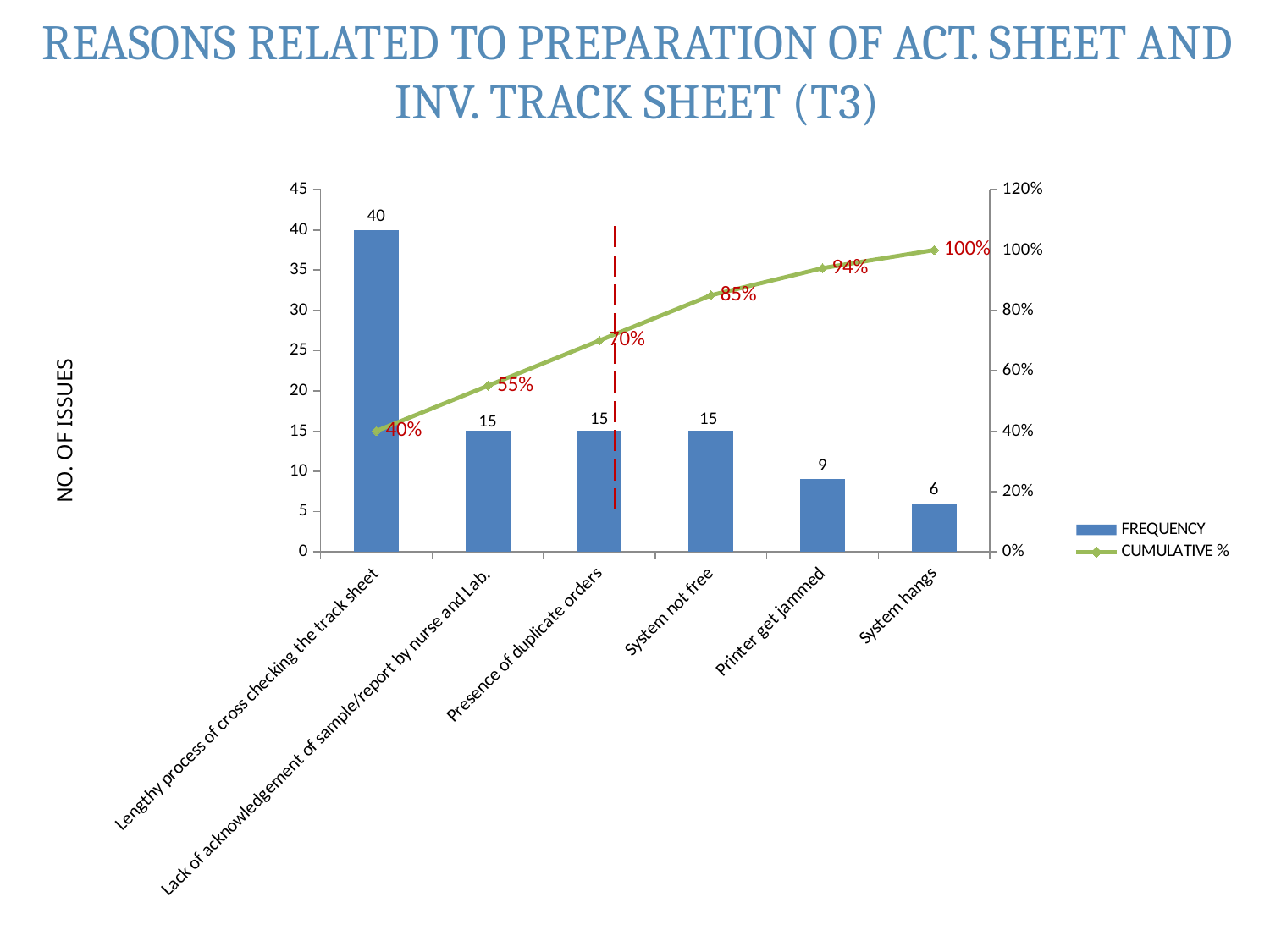
What is the cumulative % at "Presence of duplicate orders"? 70% Which category has the highest frequency? Lengthy process of cross checking the track sheet Which has a higher frequency, "Printer get jammed" or "System hangs"? Printer get jammed Does the CUMULATIVE % line rise or fall from left to right? Rises What is the difference in frequency between "Lengthy process of cross checking the track sheet" and "System not free"? 25 What kind of chart is used for the FREQUENCY series? Bar chart Which category has the lowest frequency? System hangs How many series does the legend list? 2 What is the frequency for "Lengthy process of cross checking the track sheet"? 40 How many categories are shown on the x axis? 6 What is the frequency for "Printer get jammed"? 9 What is the cumulative % at "System hangs"? 100%